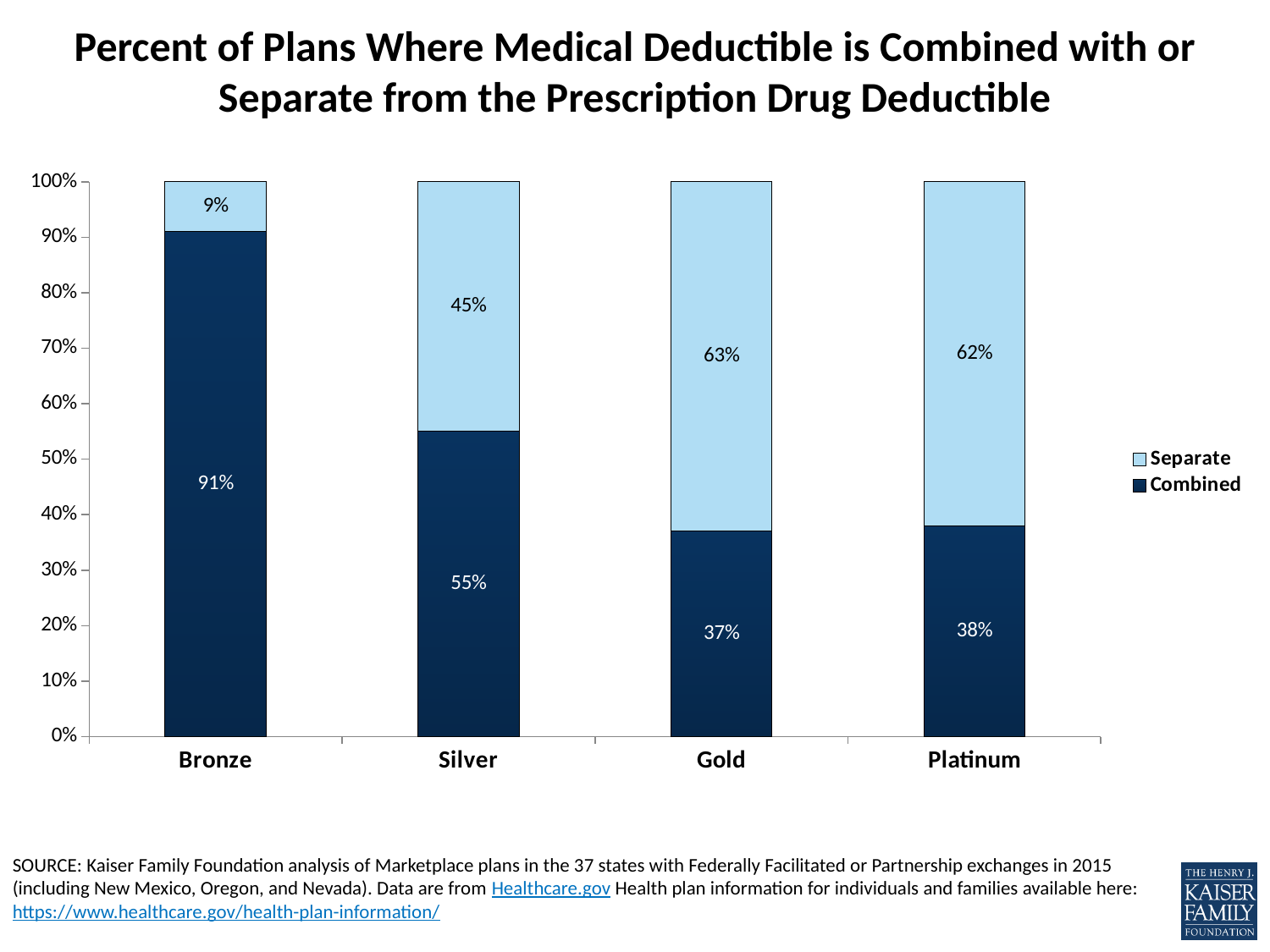
How many metal levels are shown on the x axis? 4 Is the Combined value for Silver greater or less than 50%? greater What is the difference between the Combined percentages for Bronze and Silver? 36 percentage points Which metal level has the lowest share of plans with a Combined deductible? Gold What percent of Gold plans have a Separate deductible? 63% What percent of Bronze plans have a Combined deductible? 91% What percent of Platinum plans have a Combined deductible? 38% What kind of chart is shown on the slide? Stacked bar chart Which metal level has the highest share of plans with a Combined deductible? Bronze What percent of Silver plans have a Separate deductible? 45% How many series does the legend list? 2 Which is larger: the Separate share for Silver or the Separate share for Platinum? Platinum